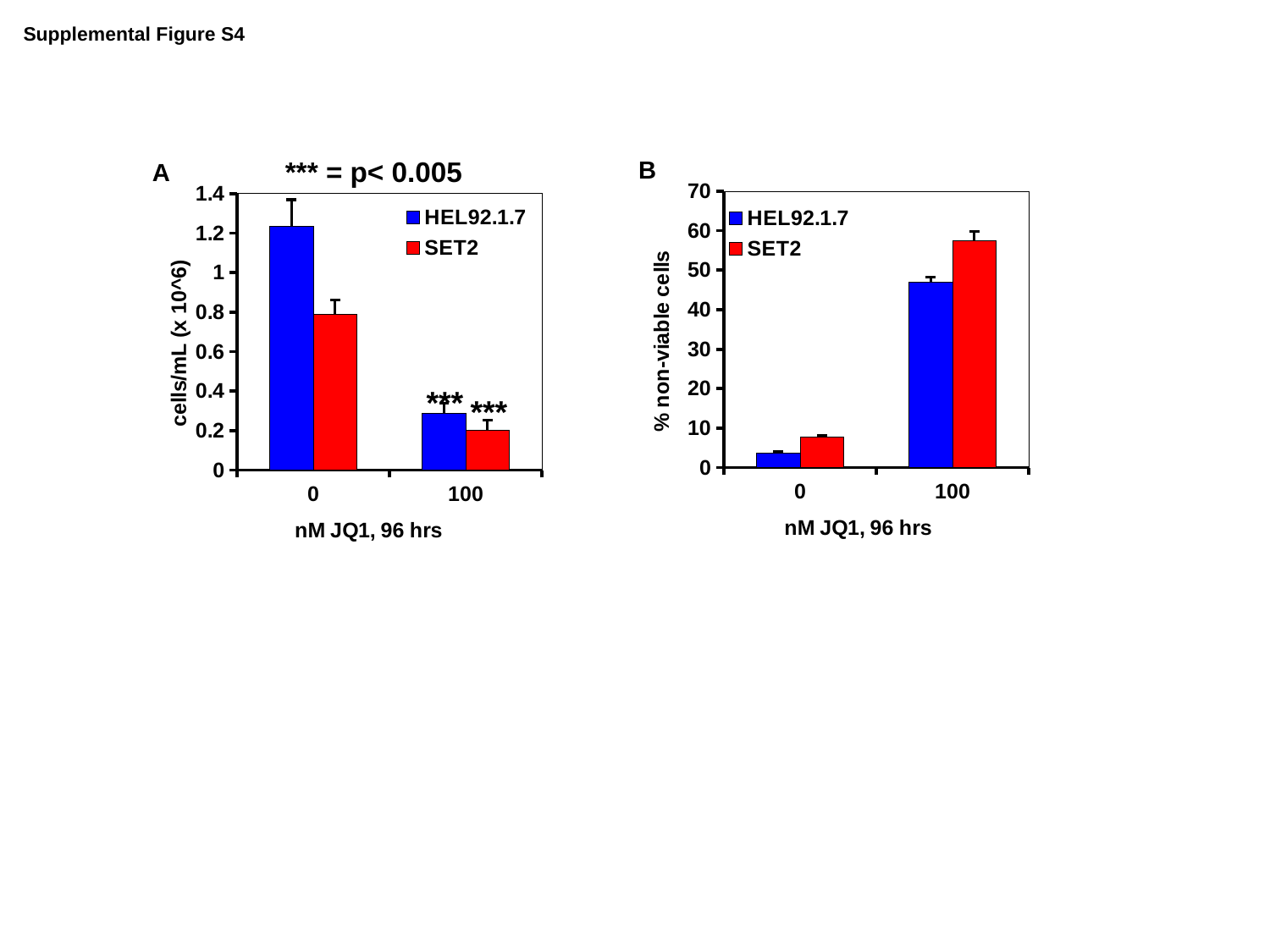
In chart A (left), what is the y-axis label? cells/mL (x 10^6) In chart A (left), how many series does the legend list? 2 In chart B (right), how many categories are on the x axis? 2 In chart B (right), do the values for SET2 rise or fall from 0 to 100 nM JQ1? rise In chart A (left), is the value for SET2 at 100 nM JQ1 greater or less than 0.4? less In chart A (left), what kind of chart is shown? bar chart In chart A (left), do the values for HEL92.1.7 rise or fall from 0 to 100 nM JQ1? fall In chart A (left), which series has the higher value at 0 nM JQ1? HEL92.1.7 In chart A (left), is the value for HEL92.1.7 at 0 nM JQ1 greater or less than 1? greater In chart B (right), is the value for HEL92.1.7 at 100 nM JQ1 greater or less than 40? greater In chart B (right), what kind of chart is shown? bar chart In chart B (right), which series has the higher value at 100 nM JQ1? SET2